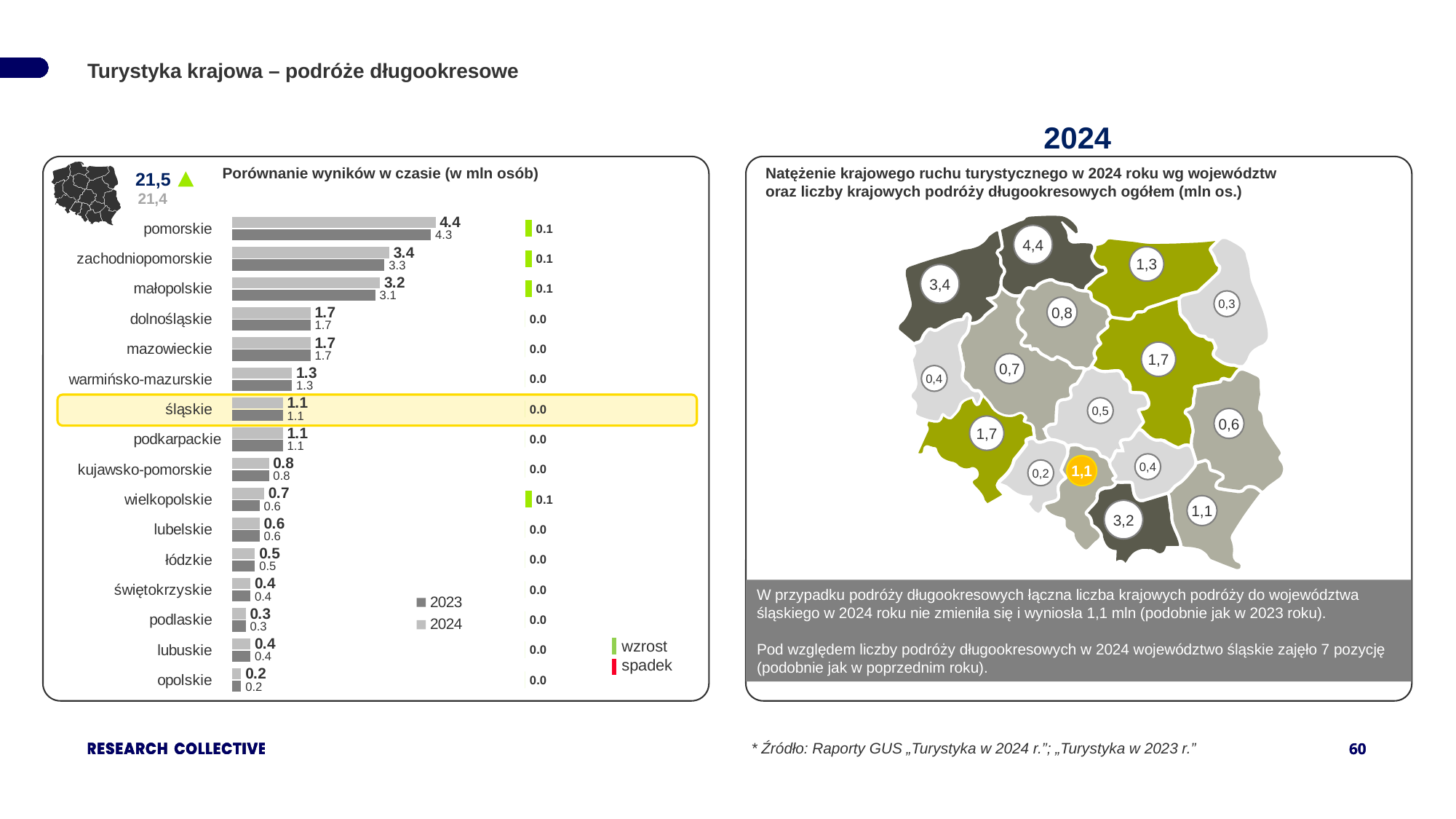
In the bar chart 'Porównanie wyników w czasie (w mln osób)', which voivodeship has the lowest 2024 value? opolskie In the bar chart 'Porównanie wyników w czasie (w mln osób)', which voivodeship has the highest 2024 value? pomorskie In the bar chart 'Porównanie wyników w czasie (w mln osób)', what is the 2024 value for pomorskie? 4.4 On the map chart on the right, what value is shown for the highlighted śląskie voivodeship? 1,1 In the bar chart 'Porównanie wyników w czasie (w mln osób)', what change value is shown next to pomorskie? 0.1 How many series does the legend of the bar chart 'Porównanie wyników w czasie (w mln osób)' list? 2 In the bar chart 'Porównanie wyników w czasie (w mln osób)', what is the difference between the 2024 values for pomorskie and małopolskie? 1.2 What kind of chart is 'Porównanie wyników w czasie (w mln osób)'? bar chart How many voivodeships are listed in the bar chart 'Porównanie wyników w czasie (w mln osób)'? 16 In the bar chart 'Porównanie wyników w czasie (w mln osób)', which is larger: the 2024 value for zachodniopomorskie or for małopolskie? zachodniopomorskie In the bar chart 'Porównanie wyników w czasie (w mln osób)', what is the 2024 value for wielkopolskie? 0.7 In the bar chart 'Porównanie wyników w czasie (w mln osób)', what is the 2023 value for zachodniopomorskie? 3.3